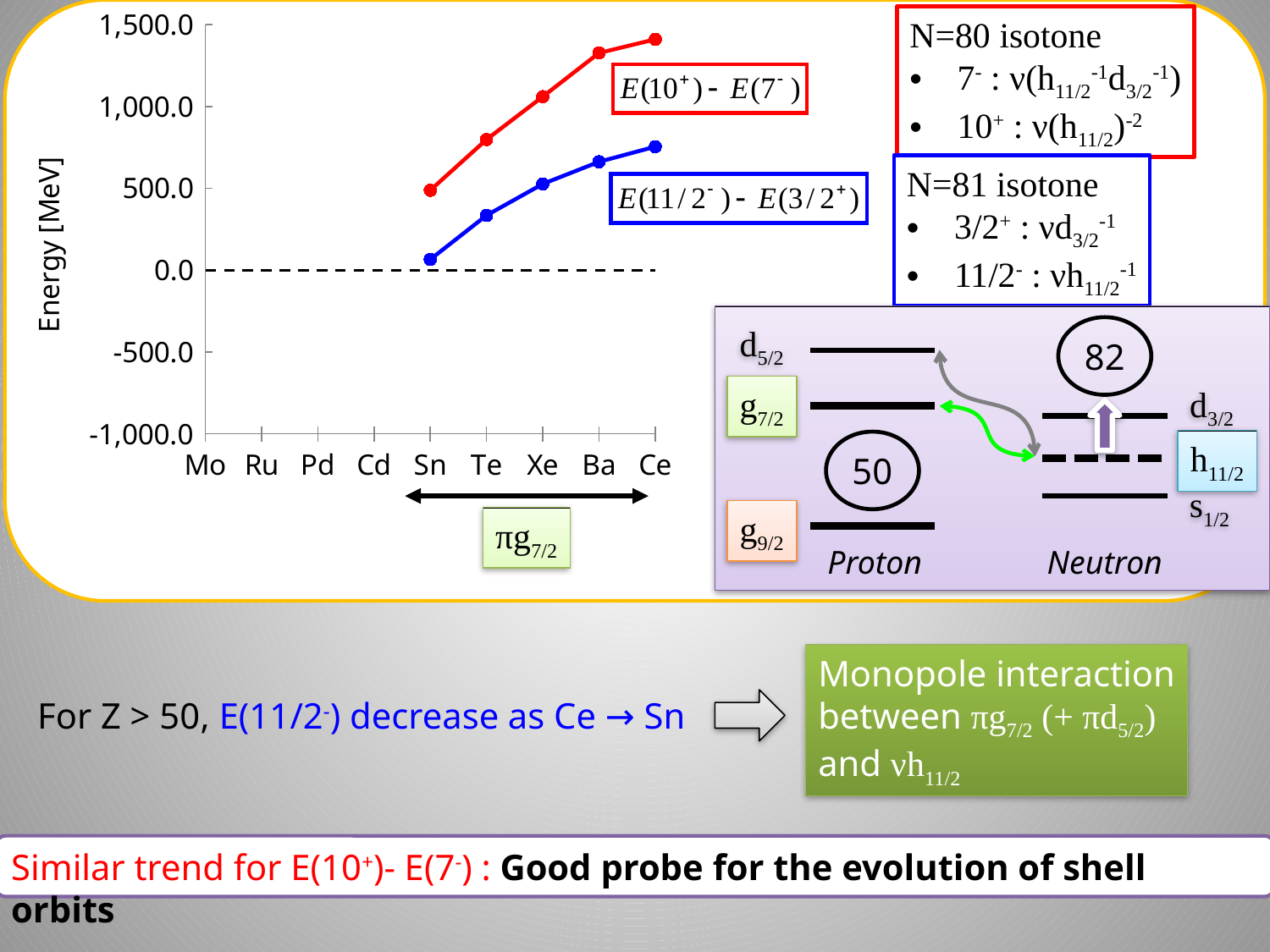
How many data series are plotted in the chart? 2 Do the E(11/2-) - E(3/2+) values rise or fall going from Sn to Ce? rise Which colour is used for the E(10+) - E(7-) series? red At Ce, which is larger: the E(10+) - E(7-) value or the E(11/2-) - E(3/2+) value? E(10+) - E(7-) Is the E(10+) - E(7-) value for Ce greater or less than 1,000.0? greater What kind of chart is shown on the slide? line chart For which element is the E(11/2-) - E(3/2+) value lowest? Sn What is the label of the y axis of the chart? Energy [MeV] For which element is the E(10+) - E(7-) value highest? Ce Is the E(11/2-) - E(3/2+) value for Te greater or less than 500.0? less How many element categories are listed along the x axis of the chart? 9 Is the E(11/2-) - E(3/2+) value for Ba greater or less than 500.0? greater